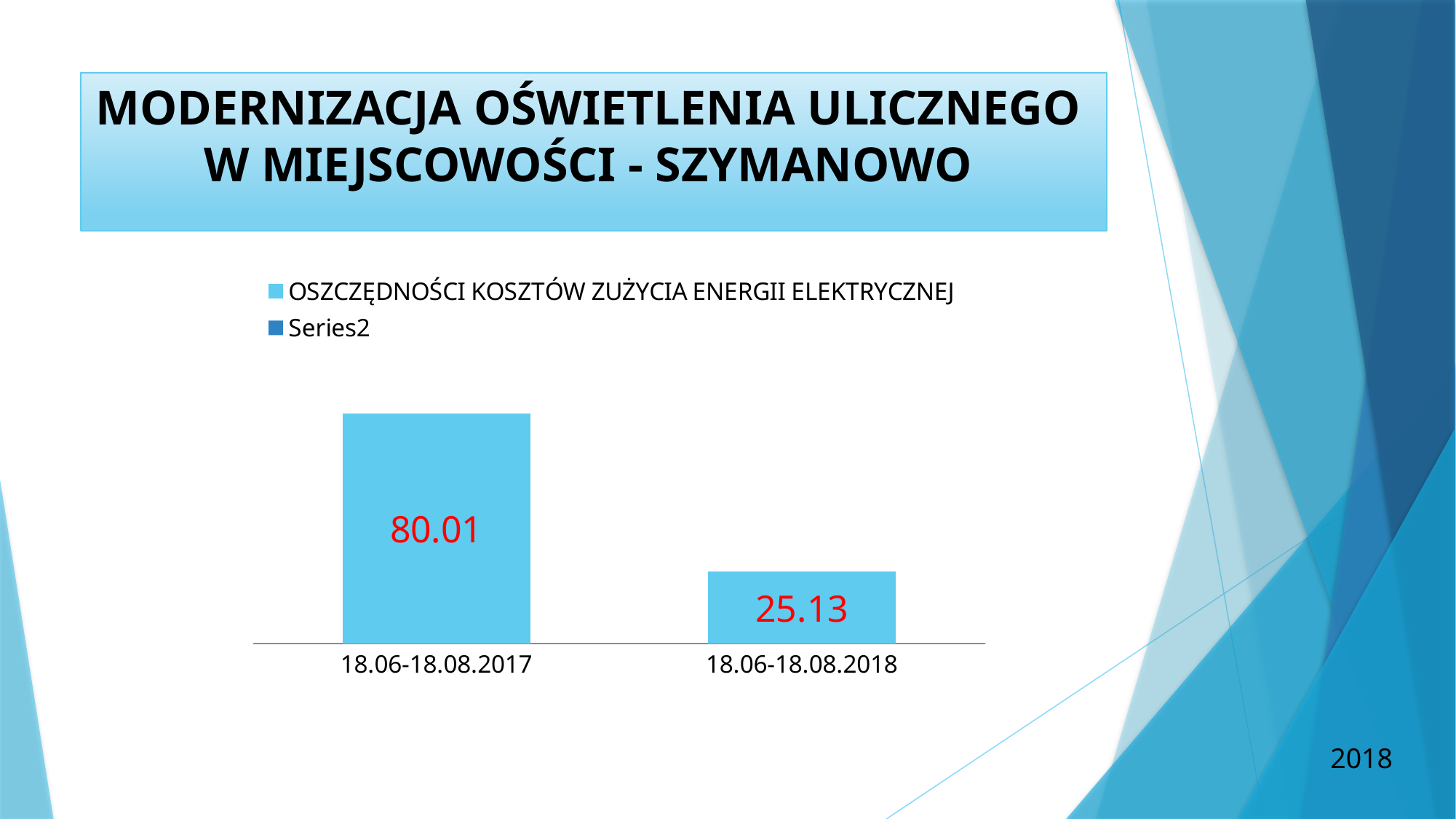
What is the value for 18.06-18.08.2018? 25.13 What is the value for 18.06-18.08.2017? 80.01 Which period has the lowest value? 18.06-18.08.2018 What kind of chart is shown on the slide? bar chart Which period has the highest value? 18.06-18.08.2017 Do the values rise or fall from 18.06-18.08.2017 to 18.06-18.08.2018? fall What is the first legend entry? OSZCZĘDNOŚCI KOSZTÓW ZUŻYCIA ENERGII ELEKTRYCZNEJ What is the second legend entry? Series2 How many series does the legend list? 2 How many categories are shown on the x axis? 2 What is the difference between the values for 18.06-18.08.2017 and 18.06-18.08.2018? 54.88 Which is larger, the value for 18.06-18.08.2017 or for 18.06-18.08.2018? 18.06-18.08.2017